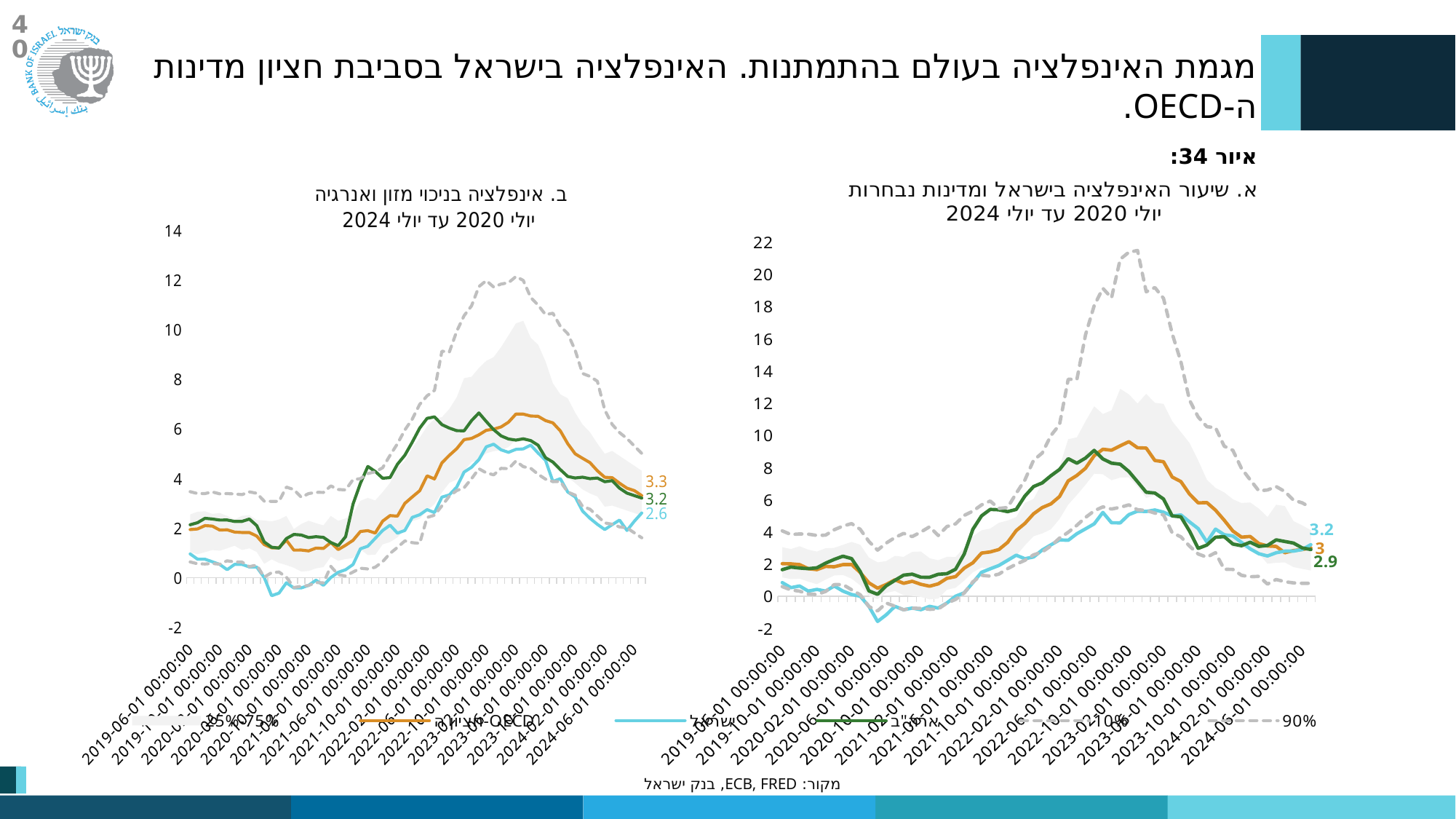
In the right chart (א. שיעור האינפלציה בישראל ומדינות נבחרות), what is the final value labelled for the light-blue line (ישראל)? 3.2 In the right chart (א. שיעור האינפלציה בישראל ומדינות נבחרות), what is the final value labelled for the green line (ארה"ב)? 2.9 In the left chart (ב. אינפלציה בניכוי מזון ואנרגיה), what is the difference between the labelled end values of the orange line (3.3) and the light-blue line (2.6)? 0.7 In the right chart (א. שיעור האינפלציה בישראל ומדינות נבחרות), is the peak of the upper dashed 90% line greater or less than 20? greater In the left chart (ב. אינפלציה בניכוי מזון ואנרגיה), which series has the lowest labelled end value? ישראל In the left chart (ב. אינפלציה בניכוי מזון ואנרגיה), what is the final value labelled for the light-blue line (ישראל)? 2.6 In the right chart (א. שיעור האינפלציה בישראל ומדינות נבחרות), which labelled end value is larger: the light-blue line (ישראל) or the green line (ארה"ב)? ישראל (3.2) What kind of chart is the left chart (ב. אינפלציה בניכוי מזון ואנרגיה)? line chart In the right chart (א. שיעור האינפלציה בישראל ומדינות נבחרות), do the solid lines rise or fall from early 2023 to mid 2024? fall